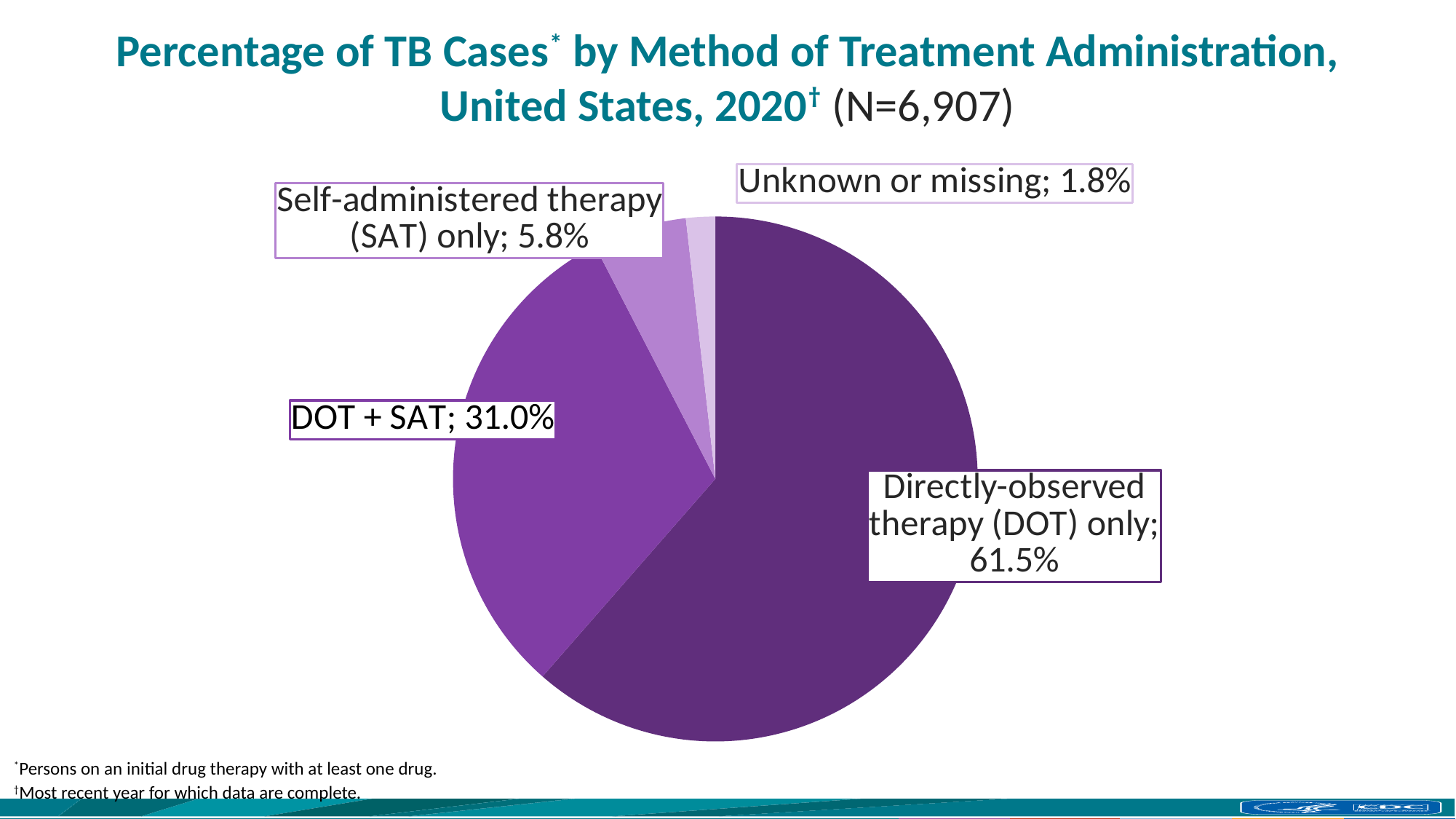
What percentage of TB cases were treated with DOT + SAT? 31.0% Which category accounts for the smallest share of TB cases? Unknown or missing What percentage of TB cases were treated with directly-observed therapy (DOT) only? 61.5% What kind of chart is shown on the slide? Pie chart What year does the chart's data refer to? 2020 How many categories are shown in the pie chart? 4 What is the total number of TB cases (N) given in the chart title? 6,907 What percentage of TB cases have an unknown or missing method of treatment administration? 1.8% What is the difference in percentage points between DOT only and DOT + SAT? 30.5 What percentage of TB cases were treated with self-administered therapy (SAT) only? 5.8% Which is larger: the share for SAT only or the share for Unknown or missing? SAT only Which method of treatment administration accounts for the largest share of TB cases? Directly-observed therapy (DOT) only